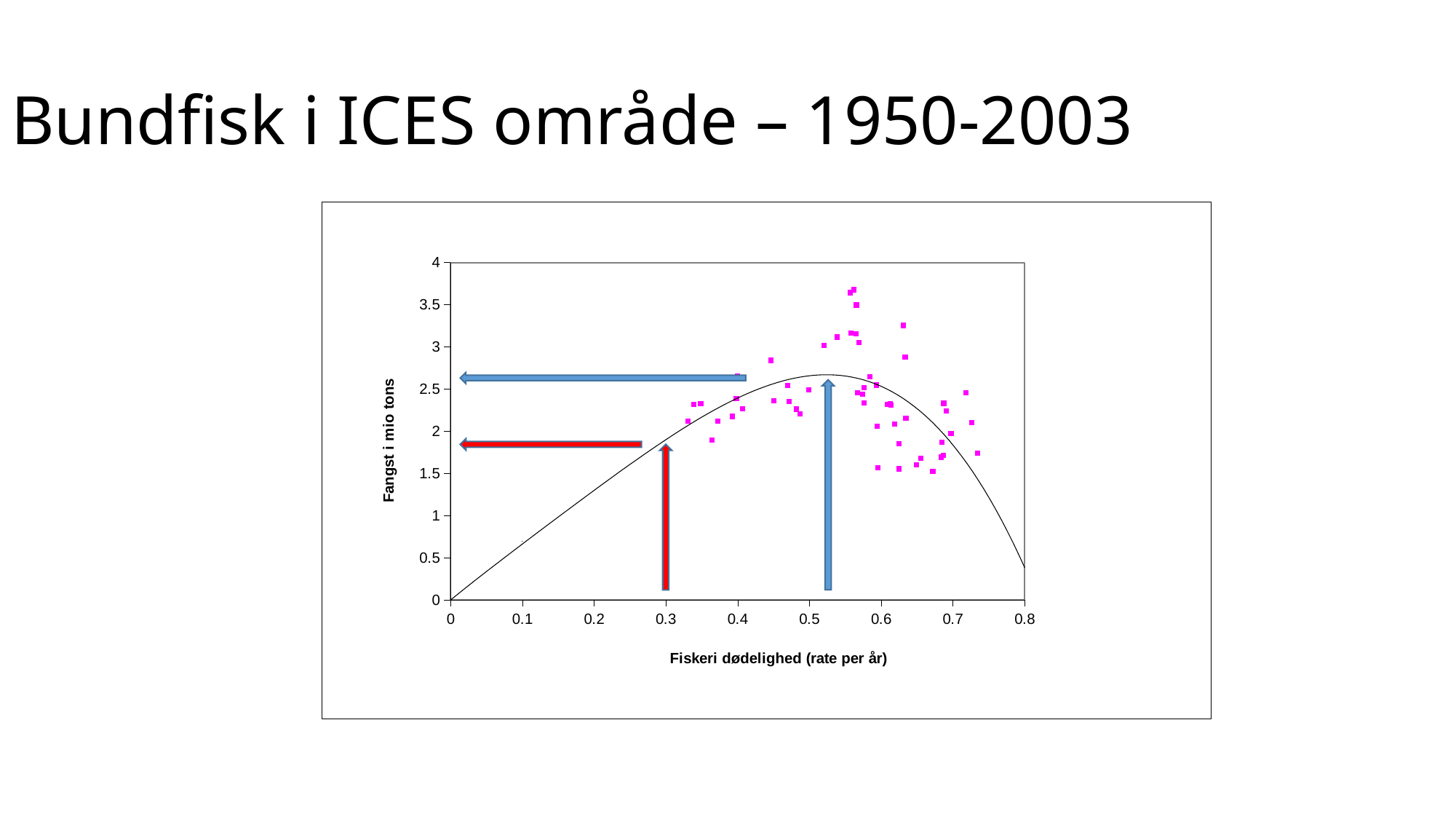
What kind of chart is shown on the slide? scatter chart Is the value of the fitted curve at a fishing mortality of 0.3 greater or less than 1.5? greater Is the value of the fitted curve at a fishing mortality of 0.8 greater or less than 1? less Is the peak value of the fitted curve greater or less than 3? less What is the highest value shown on the x axis of the chart? 0.8 Does the fitted curve rise or fall as fishing mortality increases from 0.6 to 0.8? fall What is the title of the x axis of the chart? Fiskeri dødelighed (rate per år) What is the title of the y axis of the chart? Fangst i mio tons What is the highest value shown on the y axis of the chart? 4